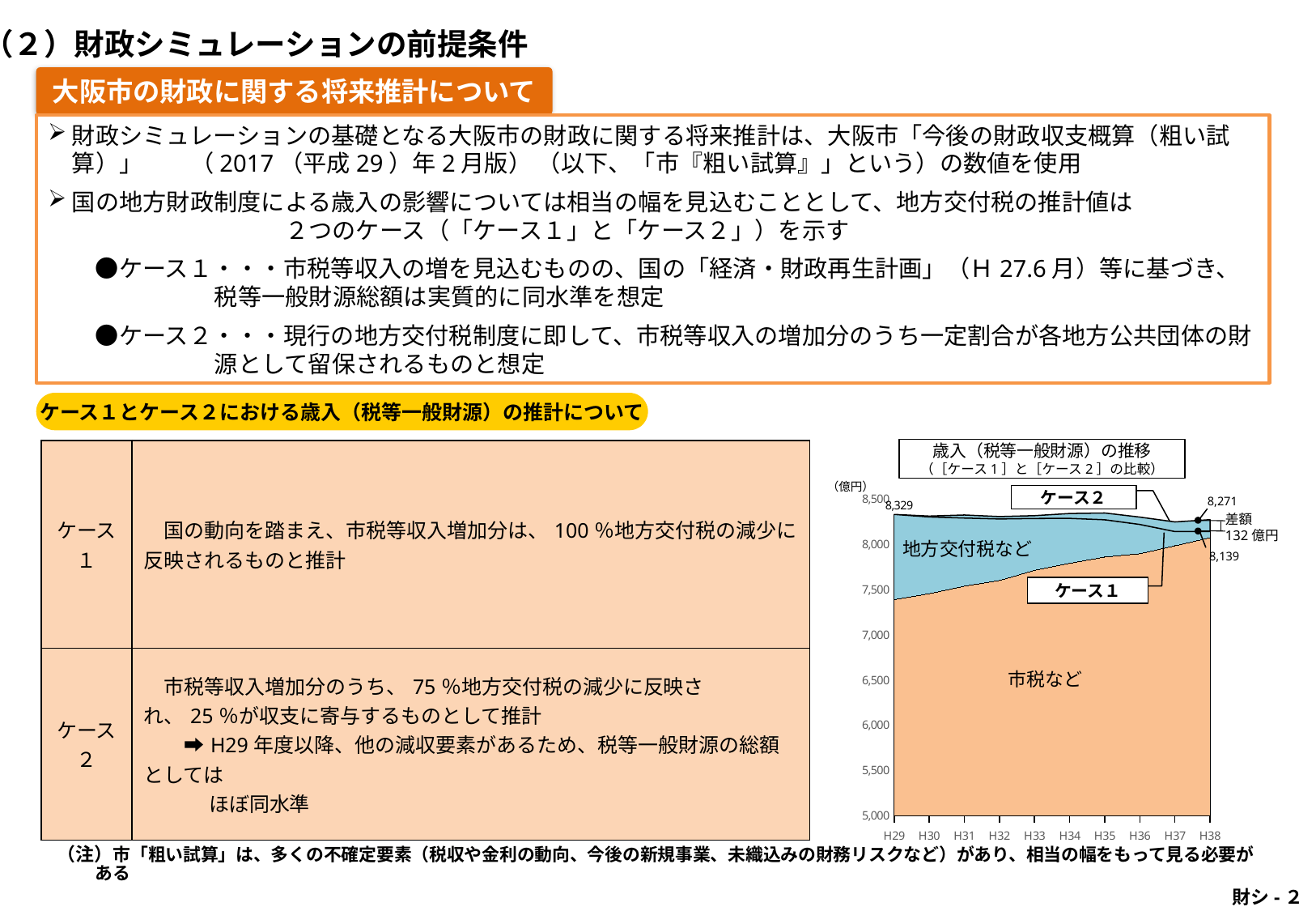
Does the ケース1 line rise or fall from H29 to H38? Fall What is the title of the chart? 歳入（税等一般財源）の推移 What kind of chart is used to show the 歳入（税等一般財源）の推移? Area chart Is the value of 市税など at H29 greater or less than 7,000? greater What is the value for ケース2 at H38 in the chart? 8,271 What does the blue area in the chart represent? 地方交付税など What is the value for ケース1 at H38 in the chart? 8,139 What is the difference (差額) between ケース2 and ケース1 at H38? 132億円 How many fiscal years are shown on the x axis of the chart? 10 What is the value of 歳入（税等一般財源） shown for H29 in the chart? 8,329 What is the lowest value shown on the y axis of the chart? 5,000 At H38, which is larger, ケース1 or ケース2? ケース2